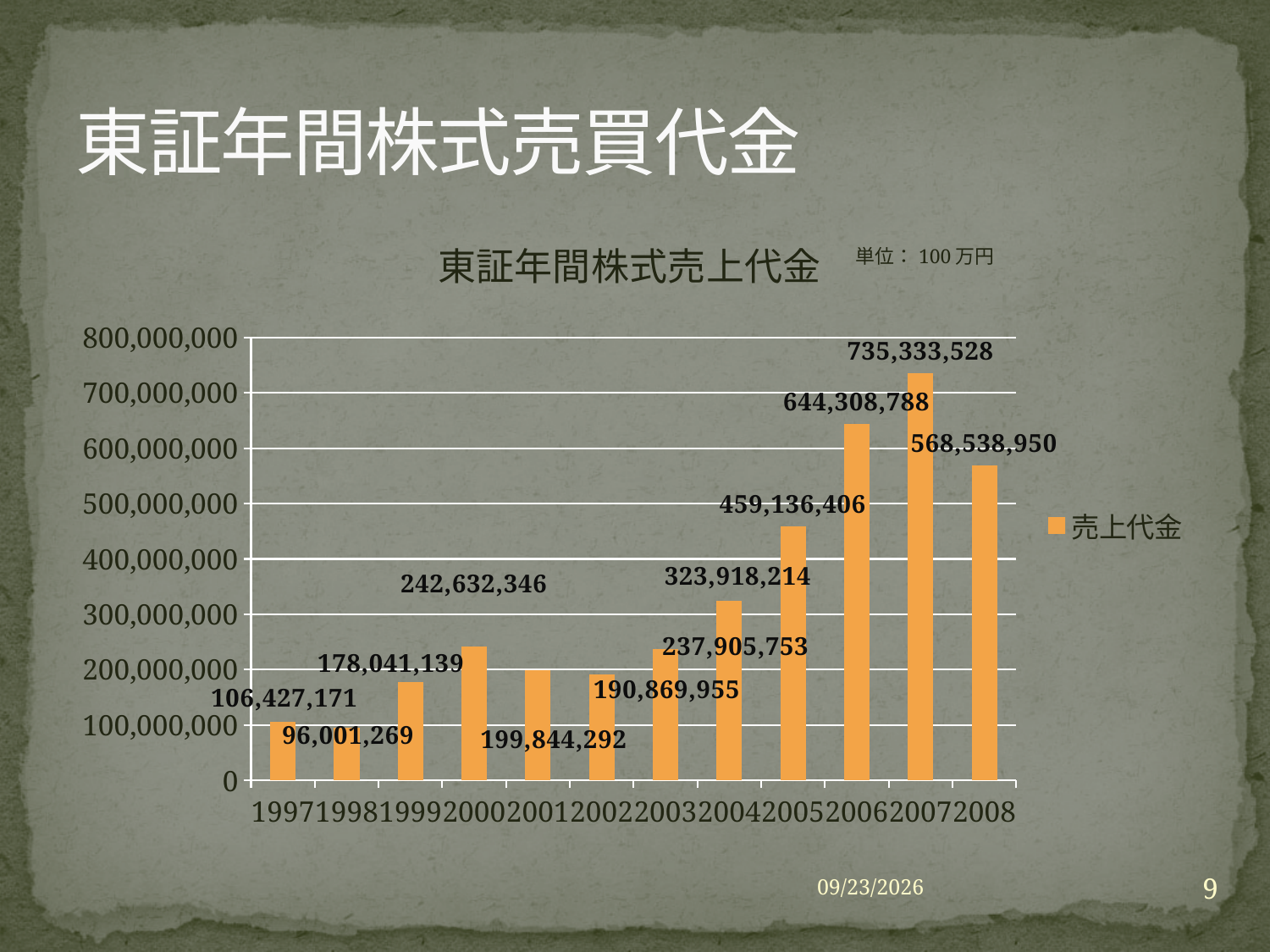
What kind of chart is shown? bar chart Which year has the lowest value? 1998 What is the difference between the values for 2007 and 2006? 91,024,740 What is the legend entry for the series? 売上代金 Is the value for 2006 greater or less than 600,000,000? greater What is the difference between the values for 2007 and 2008? 166,794,578 What is the value for 2005? 459,136,406 Which is larger, the value for 2000 or the value for 2003? 2000 What is the value for 2007? 735,333,528 What is the value for 1998? 96,001,269 How many years are shown on the x axis? 12 Which year has the highest value? 2007